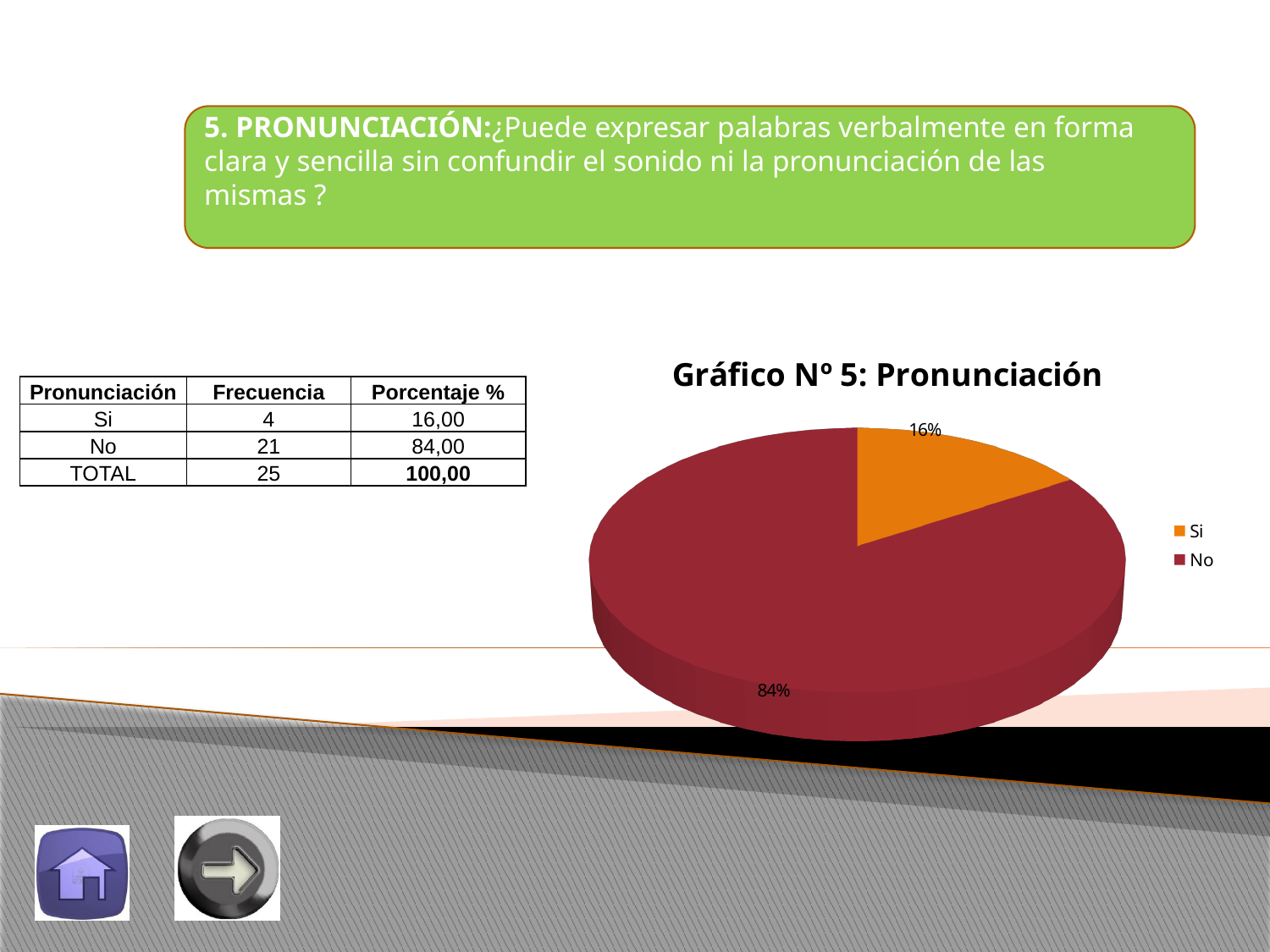
What share of the pie does the 'Si' slice represent? 16% What percentage does the 'No' slice show? 84% Which slice is the largest? No What is the difference in percentage points between the 'No' slice and the 'Si' slice? 68 What is the title of the chart? Gráfico Nº 5: Pronunciación How many entries does the legend list? 2 Which is larger, the 'Si' slice or the 'No' slice? No Which slice is the smallest? Si What kind of chart is shown on the slide? pie chart How many slices does the pie chart have? 2 What percentage does the 'Si' slice show? 16% What colour is the 'No' slice? dark red